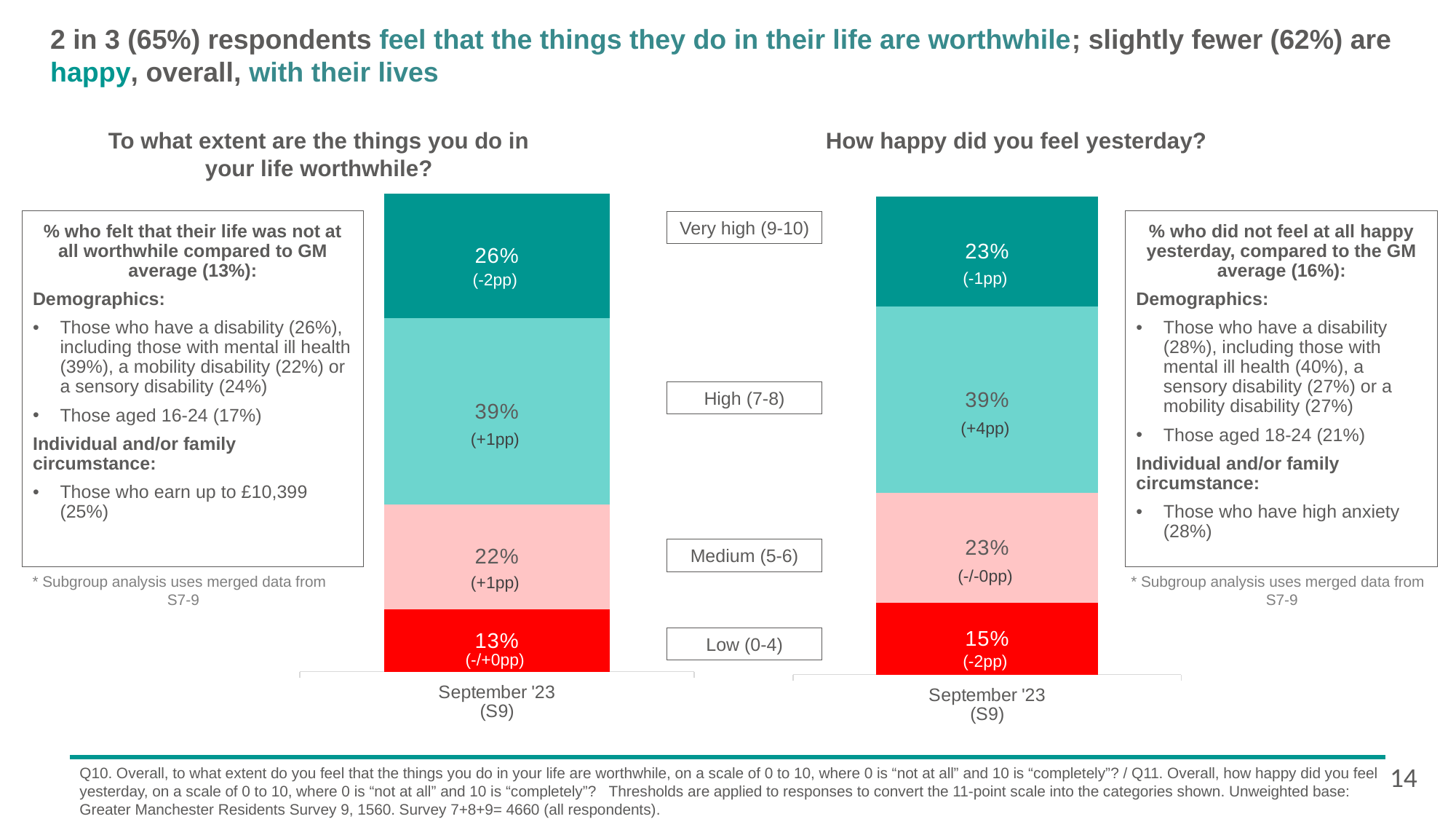
In the 'To what extent are the things you do in your life worthwhile?' chart, which category has the largest share of respondents? High (7-8) In the 'How happy did you feel yesterday?' chart, which category has the smallest share of respondents? Low (0-4) In the 'To what extent are the things you do in your life worthwhile?' chart, what is the combined percentage of the Very high (9-10) and High (7-8) categories? 65% In the 'How happy did you feel yesterday?' chart, what percentage of respondents are in the Medium (5-6) category? 23% Which chart has a larger Low (0-4) share: 'To what extent are the things you do in your life worthwhile?' or 'How happy did you feel yesterday?' How happy did you feel yesterday? What type of chart is used for 'To what extent are the things you do in your life worthwhile?' Stacked bar chart How many categories are stacked in the 'How happy did you feel yesterday?' bar? 4 In the 'How happy did you feel yesterday?' chart, what percentage of respondents are in the Low (0-4) category? 15% In the 'How happy did you feel yesterday?' chart, what is the combined percentage of the Very high (9-10) and High (7-8) categories? 62% In the 'To what extent are the things you do in your life worthwhile?' chart, what percentage of respondents are in the Very high (9-10) category? 26% What is the x-axis label under the bar in the 'How happy did you feel yesterday?' chart? September '23 (S9) In the 'To what extent are the things you do in your life worthwhile?' chart, what is the difference in percentage points between the High (7-8) and Medium (5-6) categories? 17